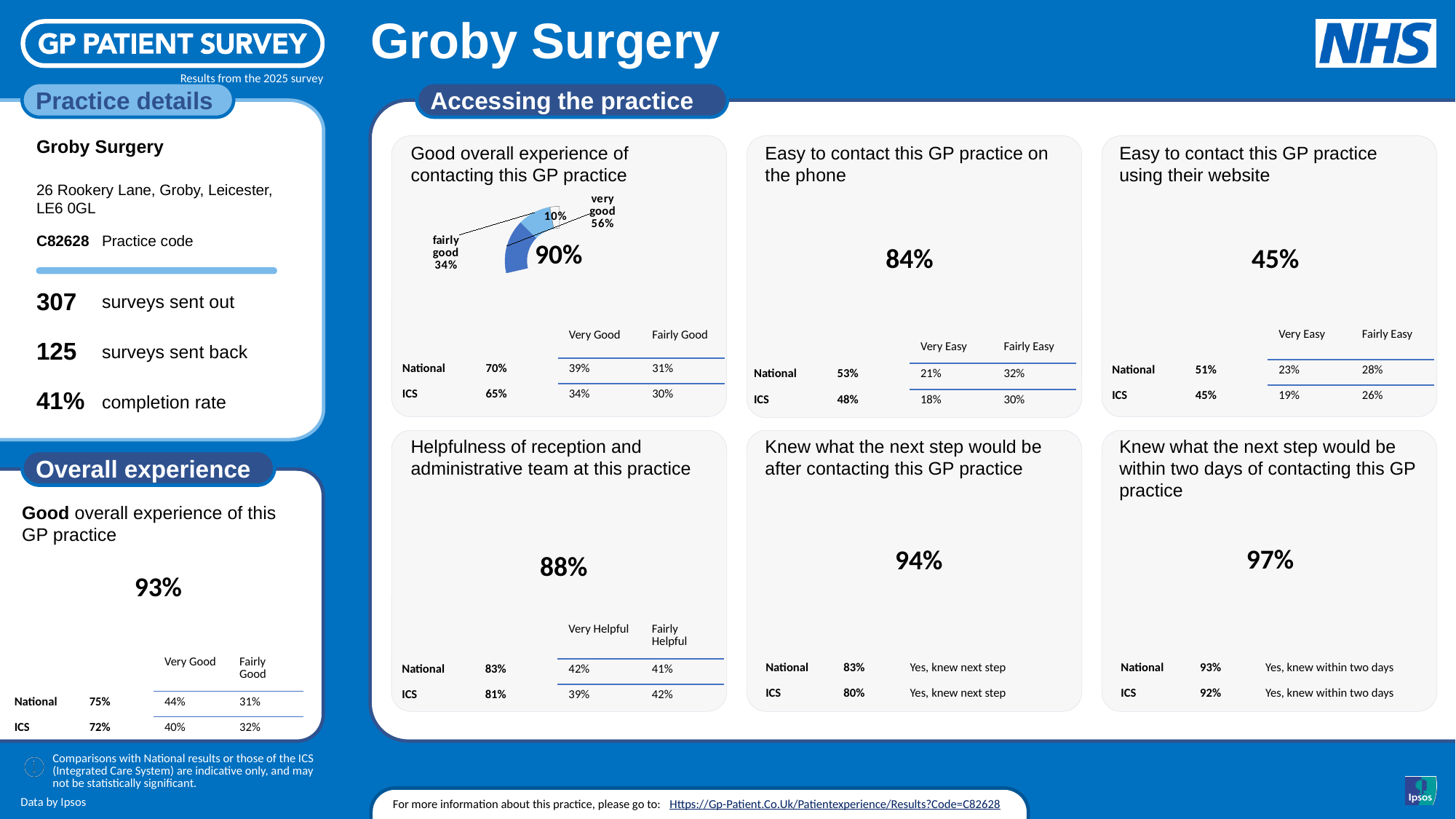
In the 'Good overall experience of contacting this GP practice' chart, what percentage is shown for 'fairly good'? 34% What is the title of the panel containing the pie chart on the slide? Good overall experience of contacting this GP practice In the 'Good overall experience of contacting this GP practice' chart, which is larger: 'very good' or 'fairly good'? very good In the 'Good overall experience of contacting this GP practice' chart, what percentage is shown for 'very good'? 56% In the 'Good overall experience of contacting this GP practice' chart, which labelled slice is the largest? very good What is the large percentage printed in the centre of the 'Good overall experience of contacting this GP practice' chart? 90% What is the smallest percentage labelled on the 'Good overall experience of contacting this GP practice' chart? 10% In the 'Good overall experience of contacting this GP practice' chart, what is the difference between the 'very good' and 'fairly good' percentages? 22% How many percentage labels are shown on the slices of the 'Good overall experience of contacting this GP practice' chart? 3 In the 'Good overall experience of contacting this GP practice' chart, what do the 'very good' and 'fairly good' slices add up to? 90% What kind of chart is used in the 'Good overall experience of contacting this GP practice' panel? doughnut chart In the 'Good overall experience of contacting this GP practice' chart, is the 'very good' slice greater or less than 50%? greater